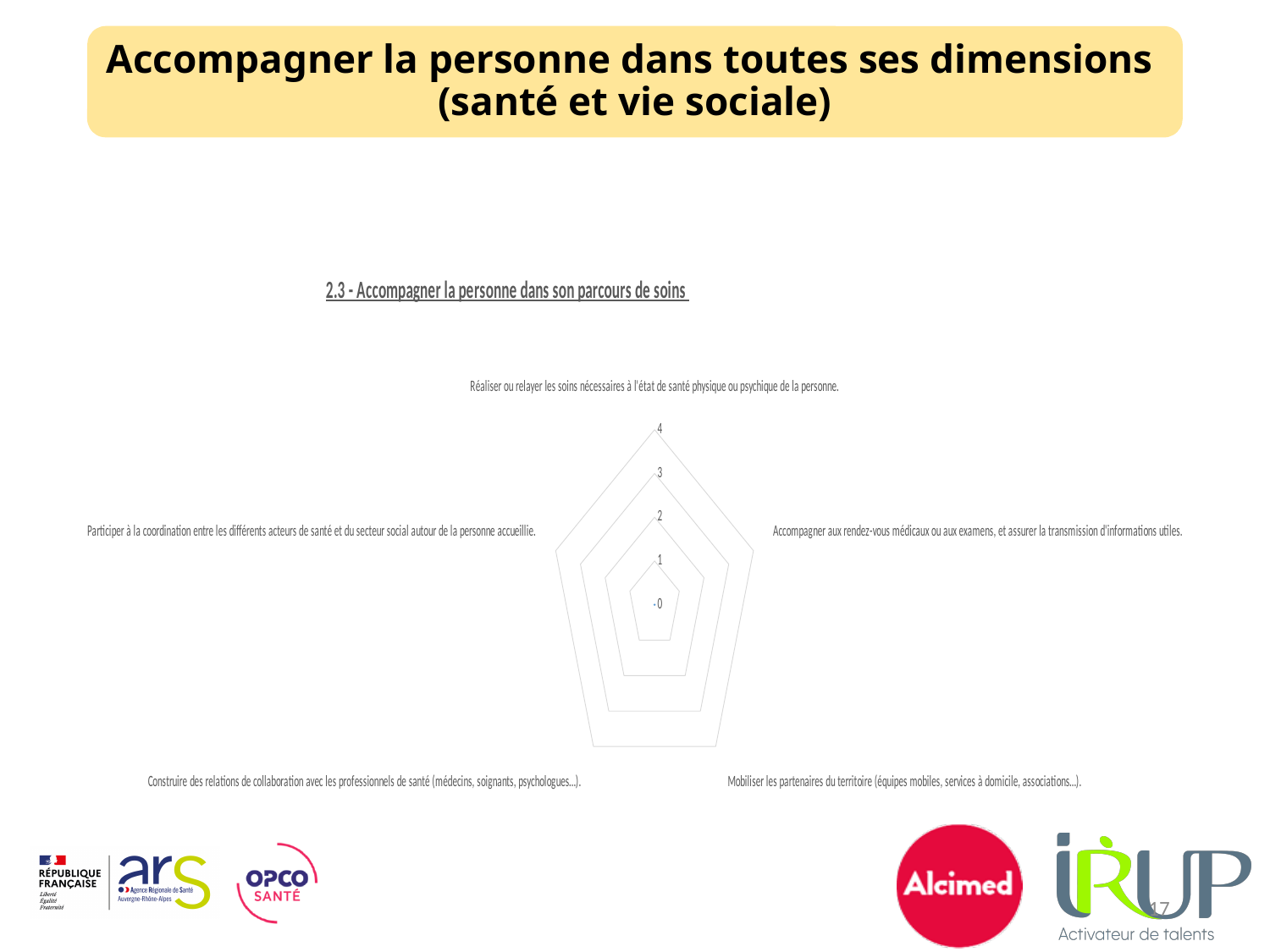
Which category label appears at the top of the radar chart? Réaliser ou relayer les soins nécessaires à l'état de santé physique ou psychique de la personne. Which category label appears at the bottom right of the radar chart? Mobiliser les partenaires du territoire (équipes mobiles, services à domicile, associations...). Which category label appears on the left side of the radar chart? Participer à la coordination entre les différents acteurs de santé et du secteur social autour de la personne accueillie. What is the highest tick value shown on the radar chart's scale? 4 Which category label appears on the right side of the radar chart? Accompagner aux rendez-vous médicaux ou aux examens, et assurer la transmission d'informations utiles. What is the lowest tick value shown on the radar chart's scale? 0 What kind of chart is shown on the slide? Radar chart How many categories (axes) does the radar chart have? 5 What is the title of the radar chart? 2.3 - Accompagner la personne dans son parcours de soins Which category label appears at the bottom left of the radar chart? Construire des relations de collaboration avec les professionnels de santé (médecins, soignants, psychologues...).